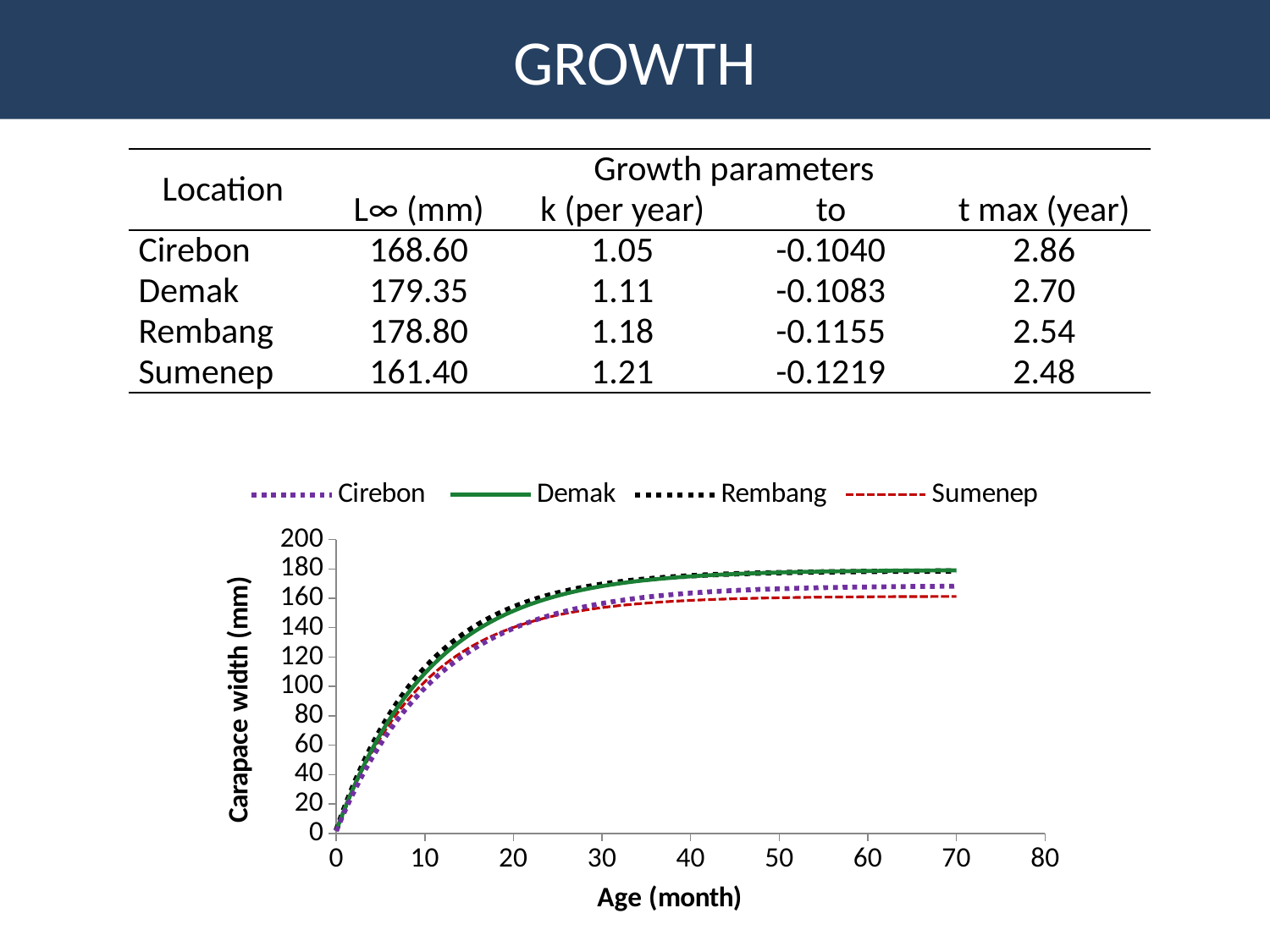
What kind of chart is shown on the slide? line chart How many series does the chart's legend list? 4 At 70 months, which has the larger carapace width, Cirebon or Sumenep? Cirebon Is the carapace width for Rembang at 10 months greater or less than 100? greater Do the carapace width curves rise or fall as age increases along the x axis? rise At 70 months, which has the larger carapace width, Demak or Sumenep? Demak Is the carapace width for Cirebon at 70 months greater or less than 180? less Which location's curve has the lowest carapace width at 70 months? Sumenep Is the carapace width for Demak at 70 months greater or less than 160? greater Which locations are listed in the chart's legend? Cirebon, Demak, Rembang, Sumenep What is the label of the chart's vertical axis? Carapace width (mm)